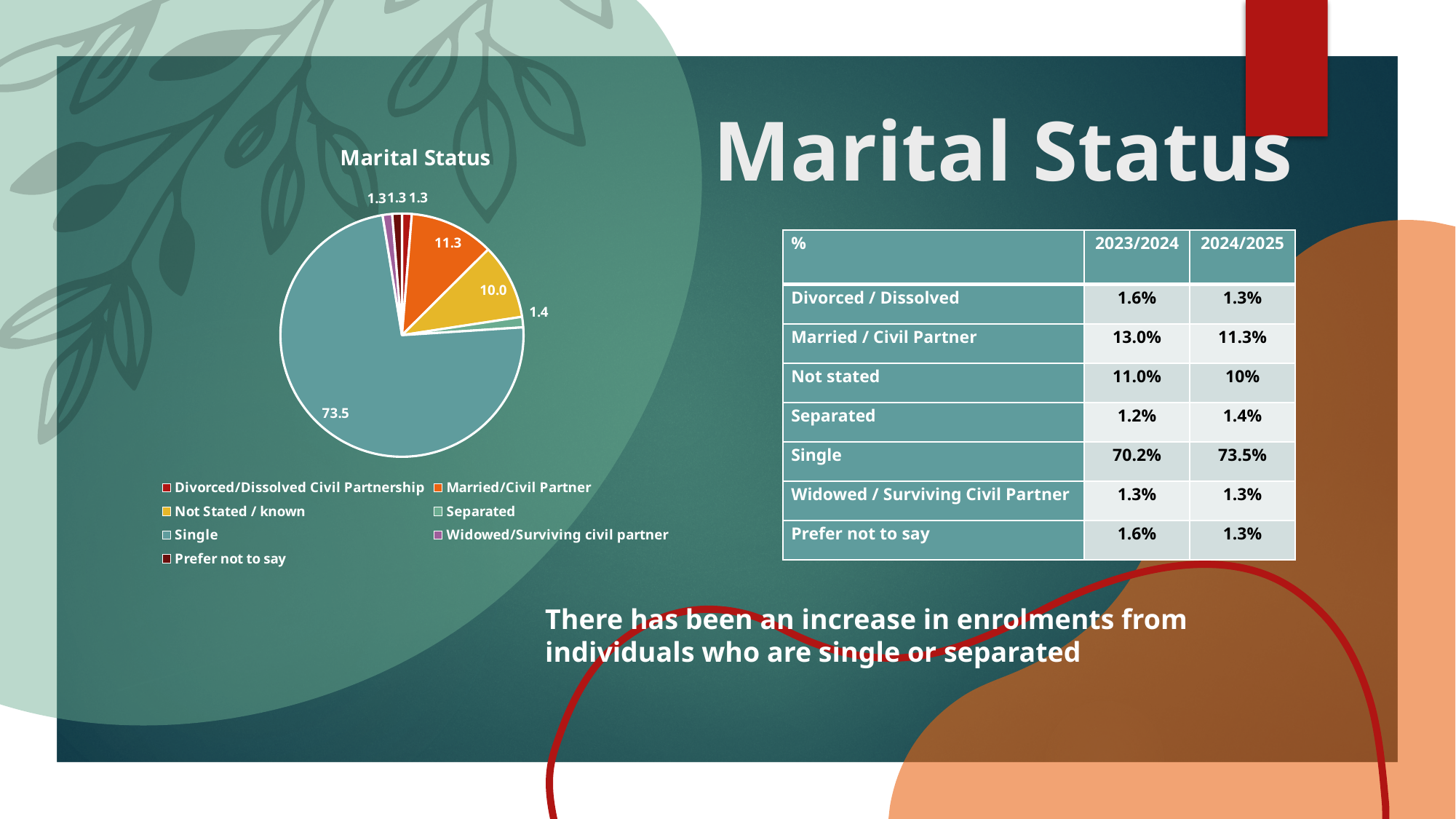
What kind of chart is shown on the slide? pie chart What value is shown for the Separated slice of the pie chart? 1.4 What is the difference between the Single value and the Married/Civil Partner value in the pie chart? 62.2 What value is shown for the Single slice of the pie chart? 73.5 What value is shown for the Married/Civil Partner slice of the pie chart? 11.3 What is the difference between the Married/Civil Partner value and the Not Stated / known value in the pie chart? 1.3 Which category has the largest slice in the pie chart? Single How many categories does the pie chart's legend list? 7 Which is larger in the pie chart, the Married/Civil Partner slice or the Not Stated / known slice? Married/Civil Partner What value is shown for the Not Stated / known slice of the pie chart? 10.0 What is the title of the chart? Marital Status What colour is the Single slice in the pie chart? teal